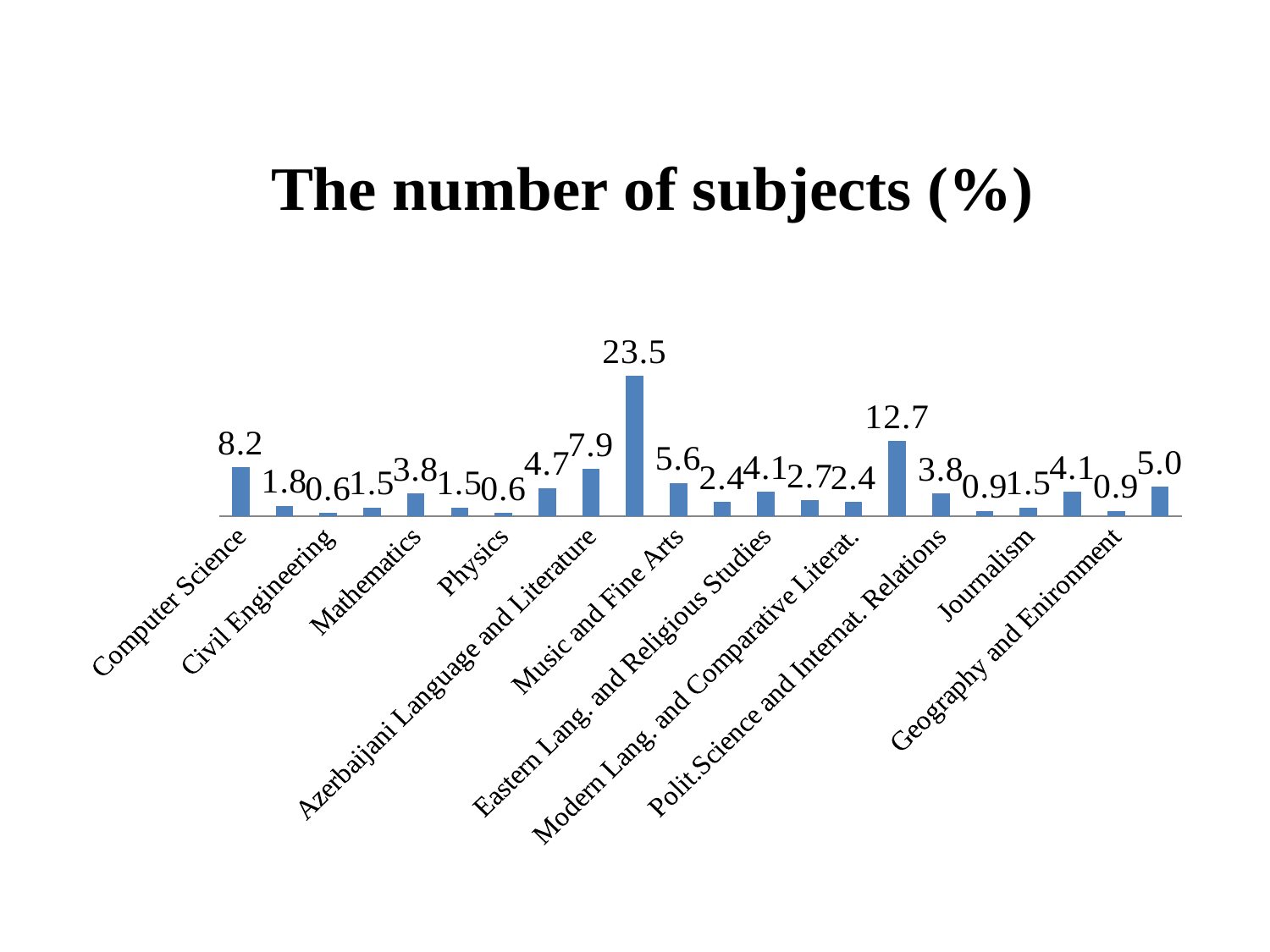
What is the title of the chart? The number of subjects (%) How many bars are plotted on the chart? 22 What is the highest value shown on the chart? 23.5 What is the lowest value shown on the chart? 0.6 What is the value for Polit.Science and Internat. Relations? 3.8 What type of chart is shown on the slide? bar chart Which is larger, the value for Music and Fine Arts or the value for Eastern Lang. and Religious Studies? Music and Fine Arts What is the value for Music and Fine Arts? 5.6 What is the value for Computer Science? 8.2 What is the value for Mathematics? 3.8 What is the value for Azerbaijani Language and Literature? 7.9 What is the difference between the values for Computer Science and Mathematics? 4.4